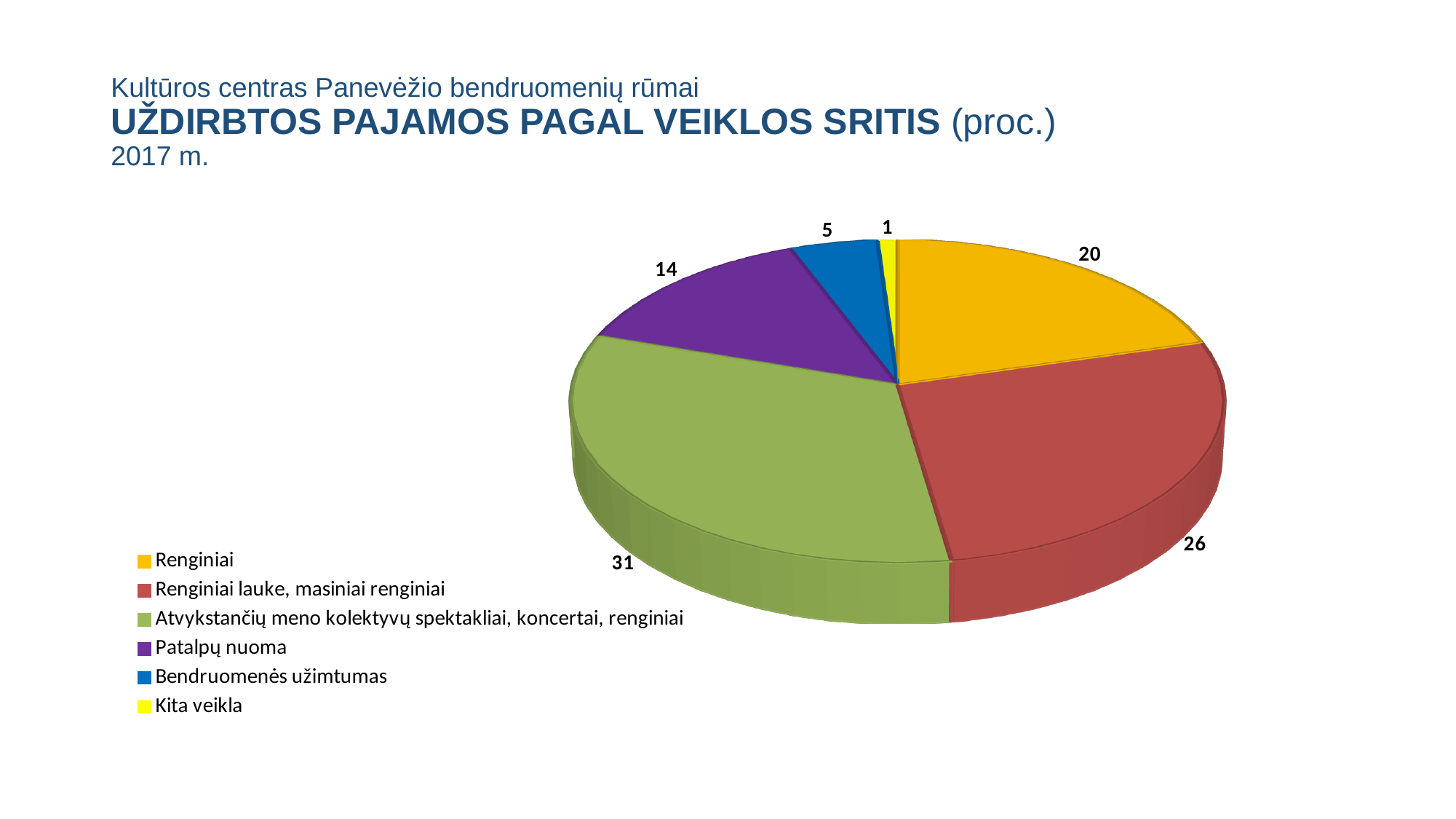
What is the value for Renginiai lauke, masiniai renginiai? 26 Which category has the smallest share of the pie? Kita veikla What kind of chart is shown on the slide? pie chart What is the value for Kita veikla? 1 How many categories does the legend list? 6 Which is larger, Patalpų nuoma or Bendruomenės užimtumas? Patalpų nuoma What is the value for Renginiai? 20 What is the difference between the values for Renginiai lauke, masiniai renginiai and Renginiai? 6 Which category has the largest share of the pie? Atvykstančių meno kolektyvų spektakliai, koncertai, renginiai What is the value for Atvykstančių meno kolektyvų spektakliai, koncertai, renginiai? 31 What is the value for Bendruomenės užimtumas? 5 What is the value for Patalpų nuoma? 14